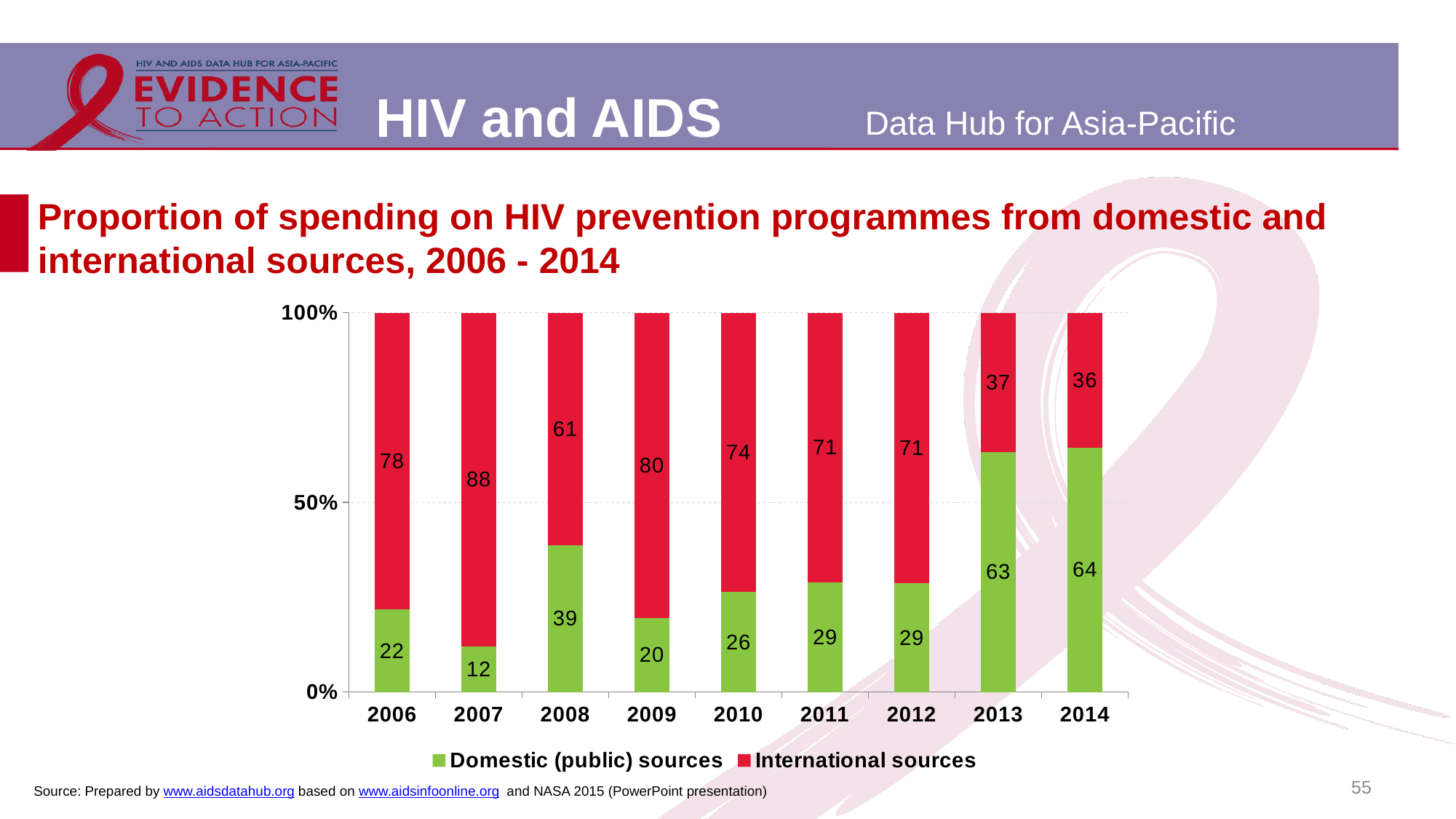
What is the value for Domestic (public) sources in 2014? 64 How many years are shown on the x axis? 9 What is the value for International sources in 2007? 88 Which is larger, the International sources value in 2009 or in 2010? 2009 In which year is the International sources value highest? 2007 How many series does the legend list? 2 What is the difference between the Domestic (public) sources values for 2014 and 2006? 42 In which year is the Domestic (public) sources value lowest? 2007 What kind of chart is shown? Stacked bar chart Is the Domestic (public) sources value for 2013 greater or less than 50%? greater What is the value for Domestic (public) sources in 2008? 39 Which colour represents International sources? Red